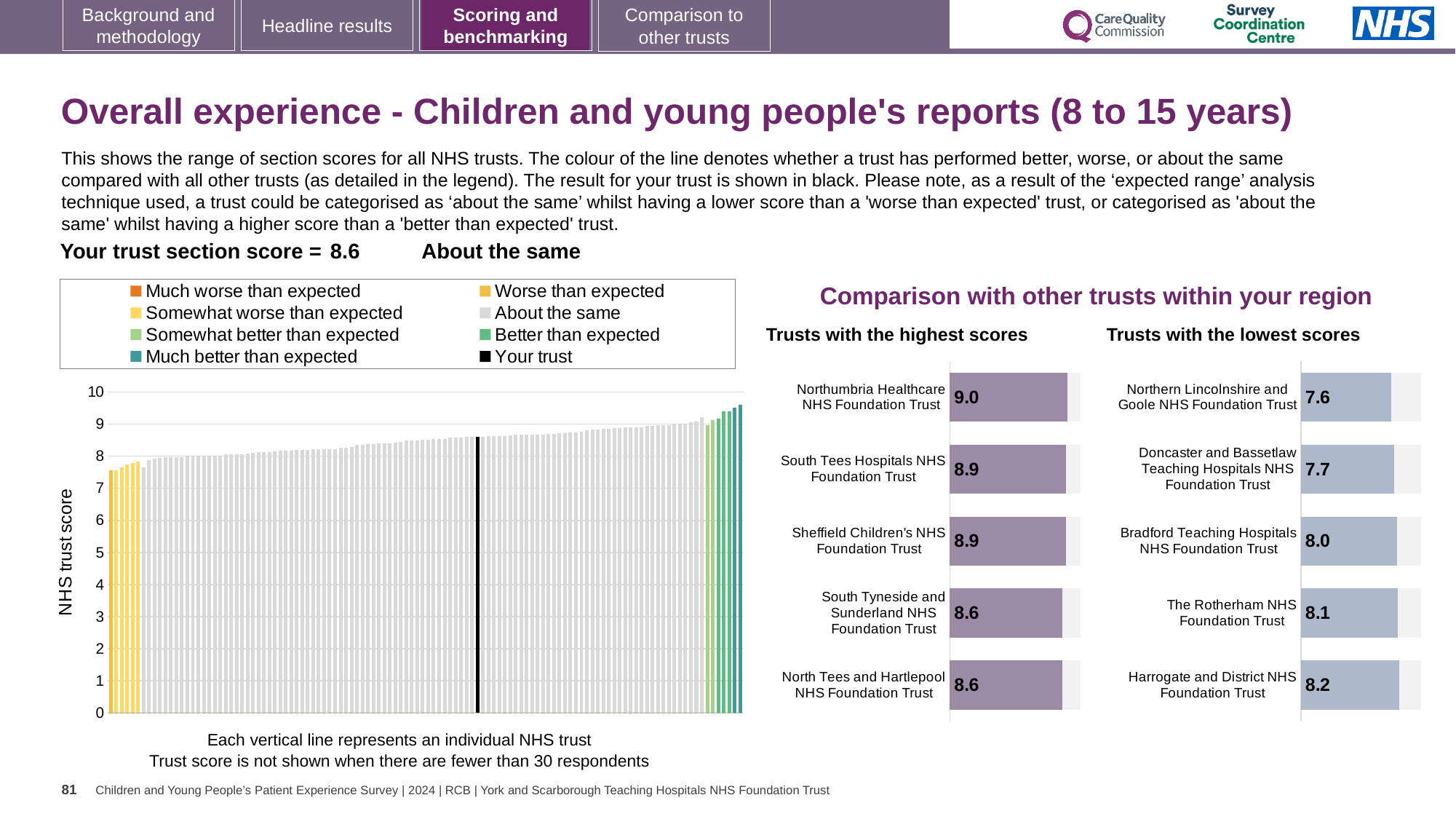
In the large chart on the left, what is the label on the vertical axis? NHS trust score How many entries does the legend above the large chart on the left list? 8 In the 'Trusts with the highest scores' chart, which trust has the highest score? Northumbria Healthcare NHS Foundation Trust In the 'Trusts with the highest scores' chart, what is the difference between the scores of Northumbria Healthcare NHS Foundation Trust and North Tees and Hartlepool NHS Foundation Trust? 0.4 In the 'Trusts with the lowest scores' chart, what is the score for Bradford Teaching Hospitals NHS Foundation Trust? 8.0 What kind of chart is the large chart on the left showing NHS trust scores? Bar chart In the 'Trusts with the lowest scores' chart, which trust has the lowest score? Northern Lincolnshire and Goole NHS Foundation Trust In the large chart on the left, do the bars rise or fall from left to right? Rise In the large chart on the left, is the value of the leftmost (shortest) bar greater or less than 8? less In the 'Trusts with the lowest scores' chart, how many trusts are shown? 5 In the large chart on the left, is the value of the tallest bar greater or less than 9? greater In the 'Trusts with the highest scores' chart, what is the score for Northumbria Healthcare NHS Foundation Trust? 9.0